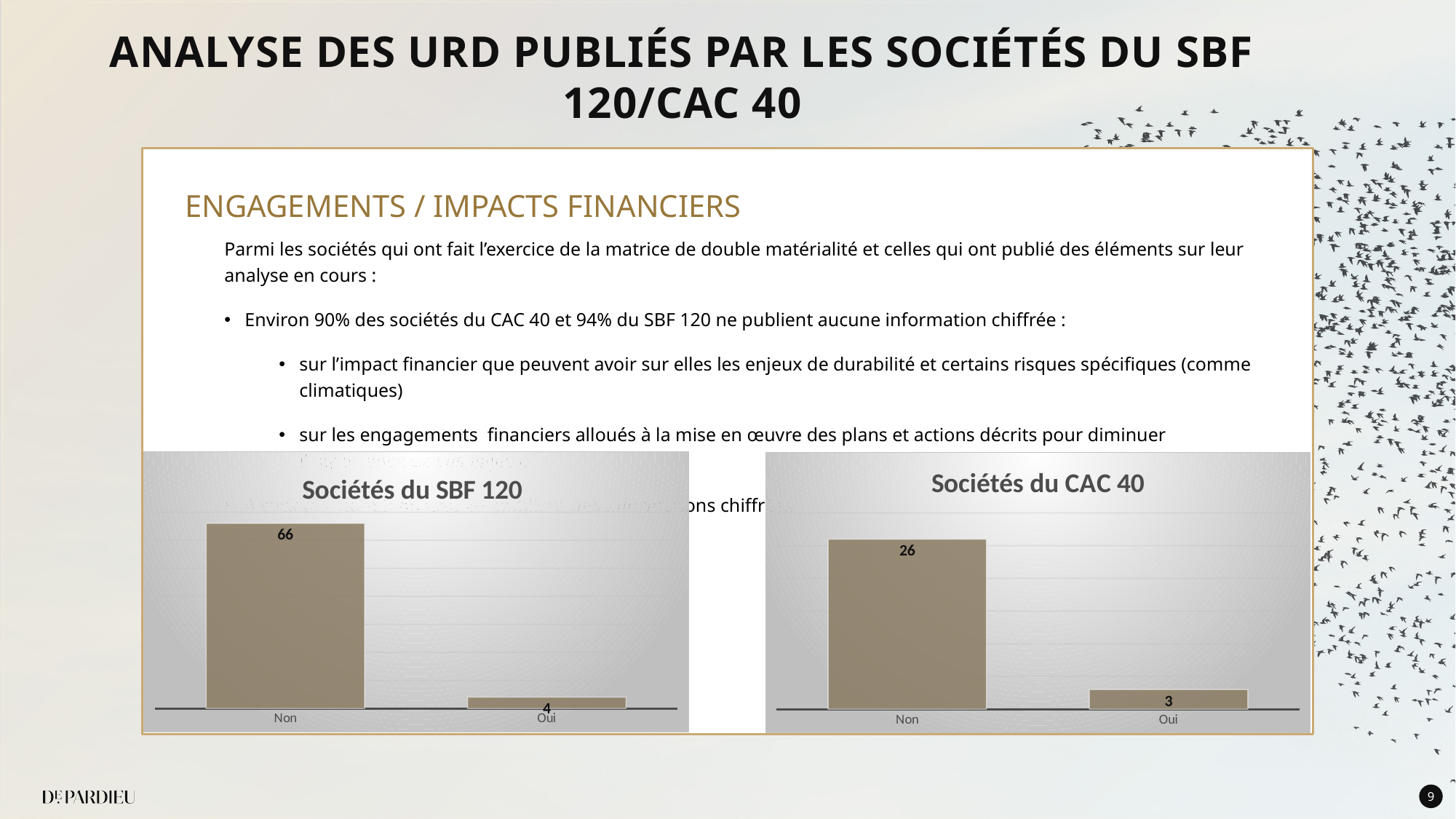
In the 'Sociétés du SBF 120' chart, what is the value for Non? 66 Which is larger: the value for Non in the 'Sociétés du SBF 120' chart or the value for Non in the 'Sociétés du CAC 40' chart? Non in the Sociétés du SBF 120 chart In the 'Sociétés du CAC 40' chart, what is the difference between the values for Non and Oui? 23 In the 'Sociétés du SBF 120' chart, what is the difference between the values for Non and Oui? 62 In the 'Sociétés du SBF 120' chart, which category has the highest value? Non In the 'Sociétés du CAC 40' chart, what is the value for Oui? 3 What is the title of the chart on the right side of the slide? Sociétés du CAC 40 In the 'Sociétés du SBF 120' chart, what is the value for Oui? 4 What kind of chart is the 'Sociétés du SBF 120' chart? Bar chart In the 'Sociétés du CAC 40' chart, what is the value for Non? 26 In the 'Sociétés du CAC 40' chart, which category has the lowest value? Oui How many categories are shown in the 'Sociétés du CAC 40' chart? 2